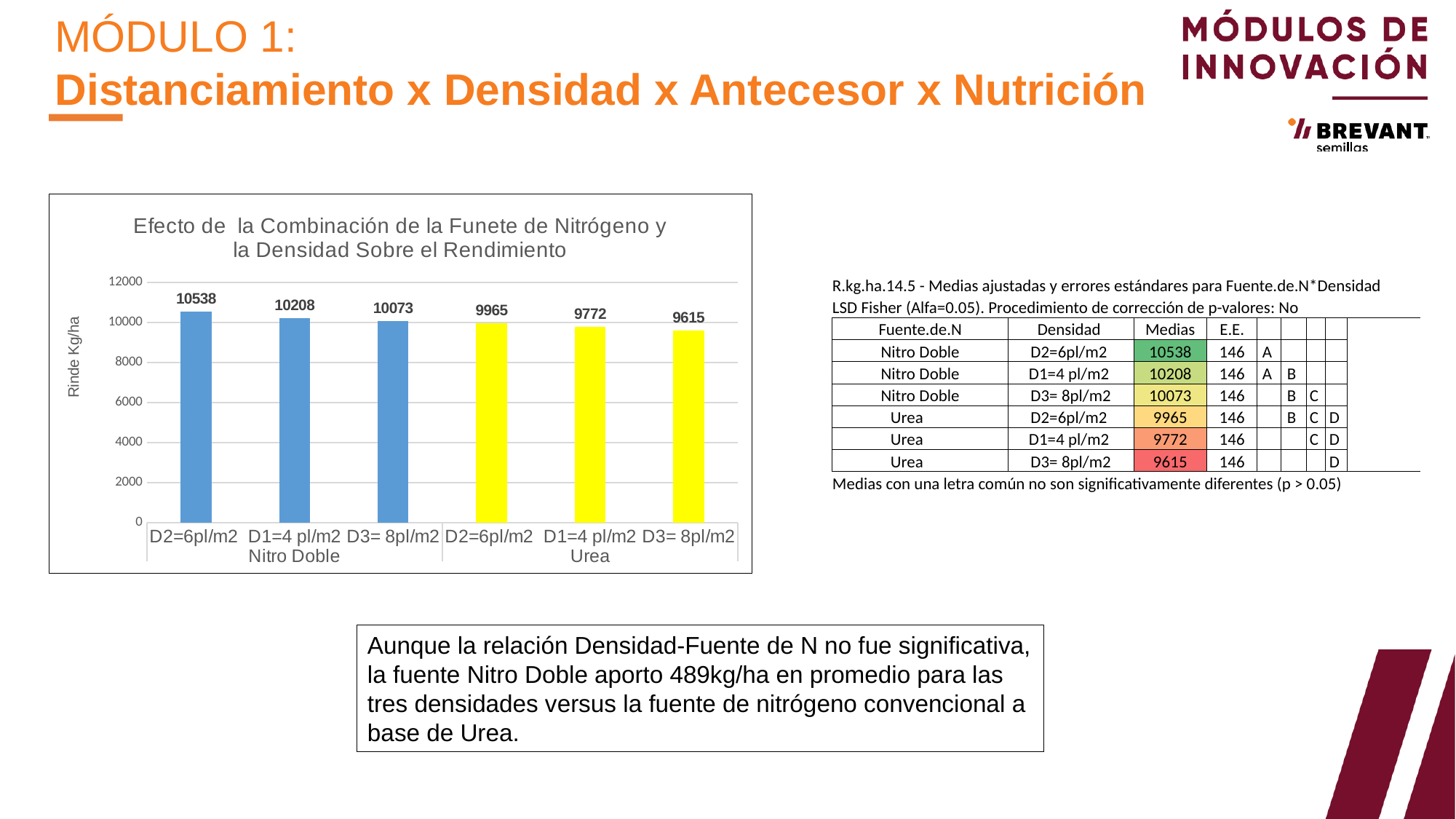
Which bar has the lowest value? Urea D3= 8pl/m2 What is the value for Urea at D3= 8pl/m2? 9615 How many bars are plotted in the chart? 6 What kind of chart is shown? Bar chart Which bar has the highest value? Nitro Doble D2=6pl/m2 What is the value for Urea at D1=4 pl/m2? 9772 What is the y-axis label of the chart? Rinde Kg/ha Do the values rise or fall from left to right across the bars? Fall What is the difference between Nitro Doble at D3= 8pl/m2 and Urea at D3= 8pl/m2? 458 What is the difference between Nitro Doble at D2=6pl/m2 and Urea at D2=6pl/m2? 573 Which is larger: Nitro Doble at D1=4 pl/m2 or Urea at D2=6pl/m2? Nitro Doble at D1=4 pl/m2 What is the value for Nitro Doble at D2=6pl/m2? 10538